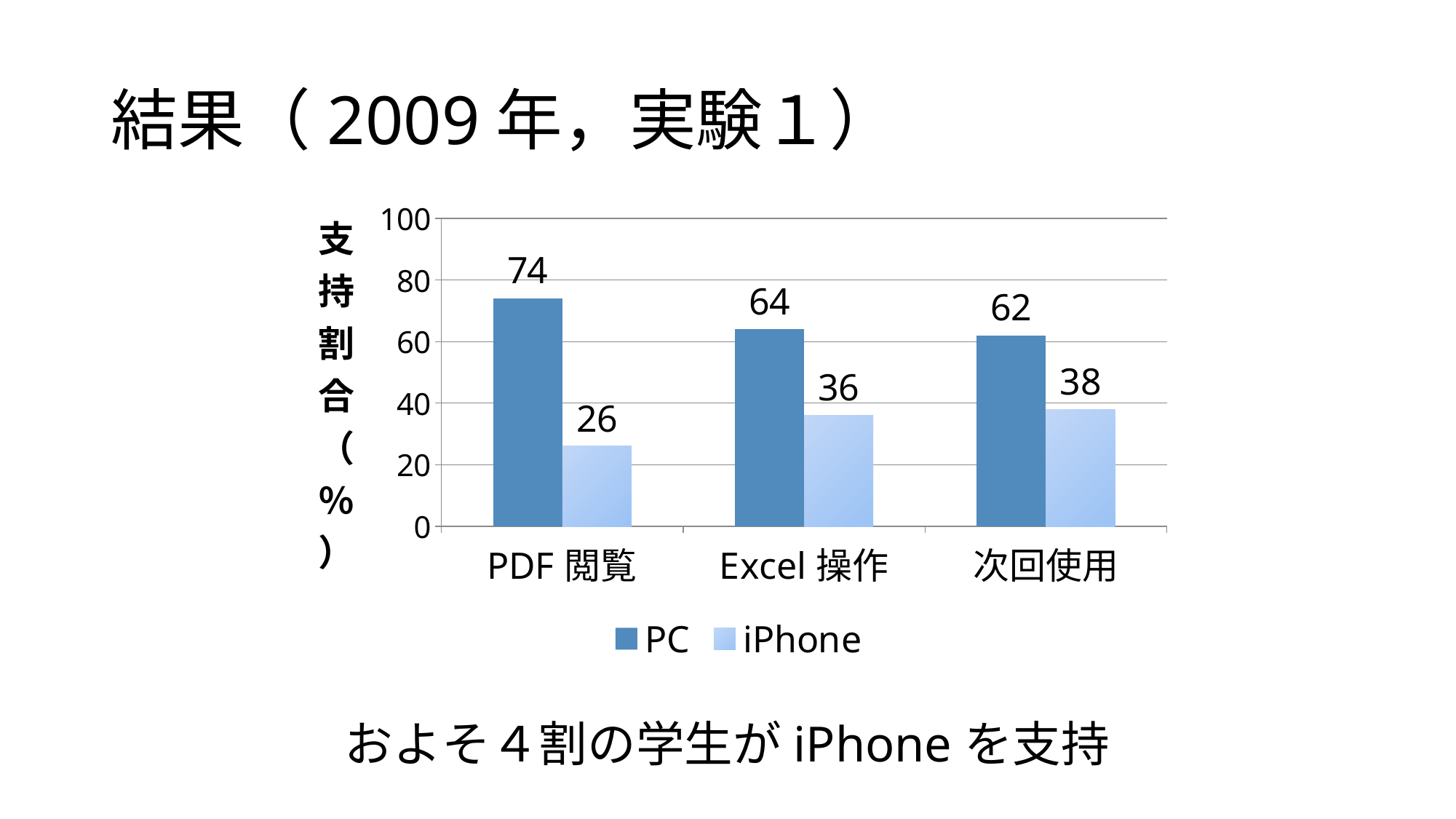
What is the iPhone value for 次回使用? 38 Which category has the highest PC value? PDF 閲覧 What is the difference between the PC values for Excel 操作 and 次回使用? 2 Which is larger for Excel 操作, the PC value or the iPhone value? PC How many series does the legend list? 2 What are the two series listed in the legend? PC and iPhone What is the difference between the PC and iPhone values for PDF 閲覧? 48 Which category has the lowest iPhone value? PDF 閲覧 How many categories are shown on the x axis? 3 What is the PC value for PDF 閲覧? 74 What kind of chart is shown on the slide? bar chart What is the iPhone value for Excel 操作? 36